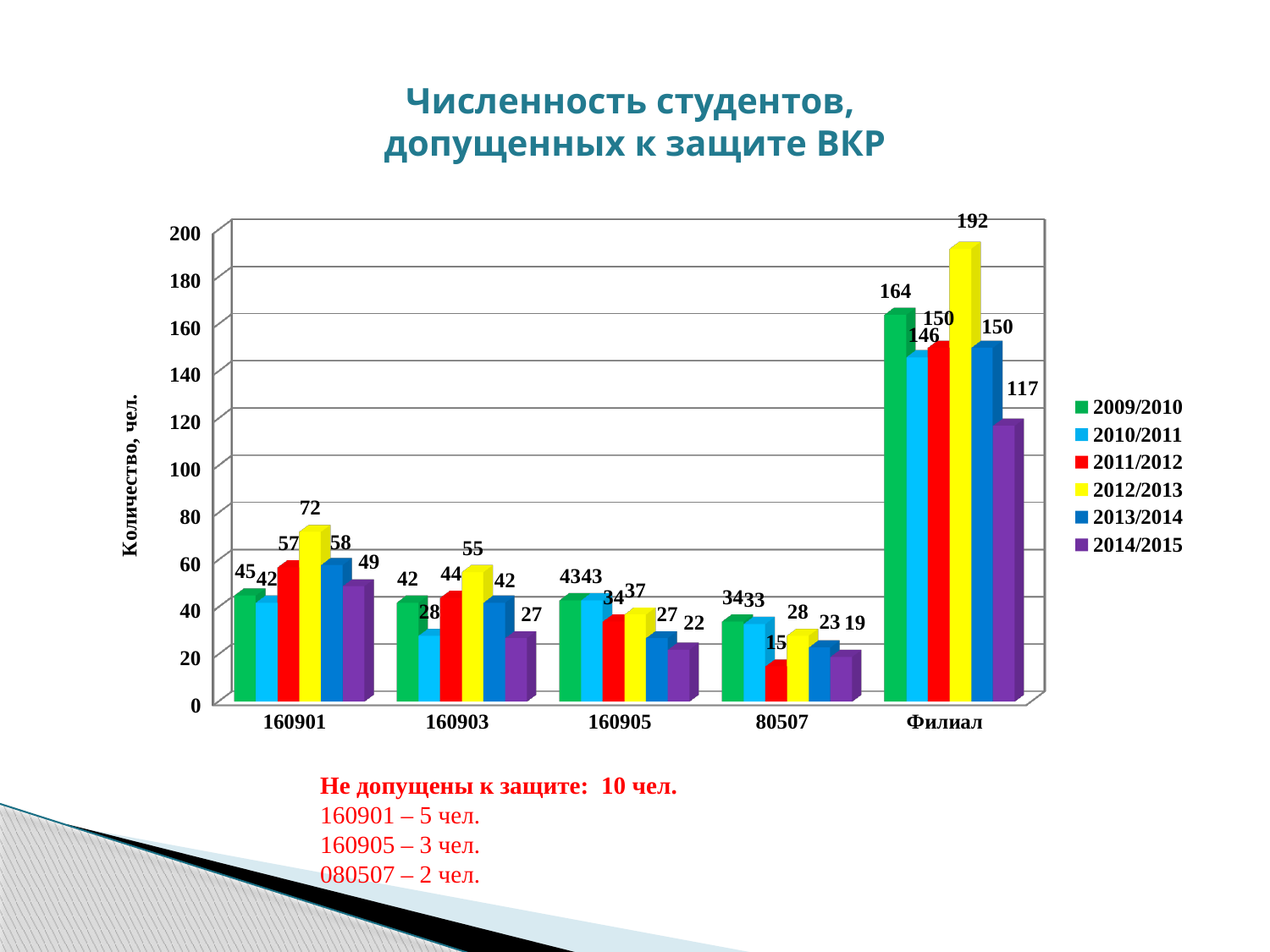
How many series does the legend list? 6 Which category has the highest value in the 2014/2015 series? Филиал How many categories are shown on the x axis? 5 Which is larger for 160903: the 2009/2010 value or the 2010/2011 value? 2009/2010 Which category has the lowest value in the 2011/2012 series? 80507 What is the difference between the 2012/2013 and 2014/2015 values for Филиал? 75 What is the value for 160901 in the 2012/2013 series? 72 What type of chart is shown on the slide? bar chart What is the value for Филиал in the 2012/2013 series? 192 What is the value for 80507 in the 2011/2012 series? 15 What is the label of the y axis? Количество, чел. Is the value for Филиал in the 2009/2010 series greater or less than 160? greater